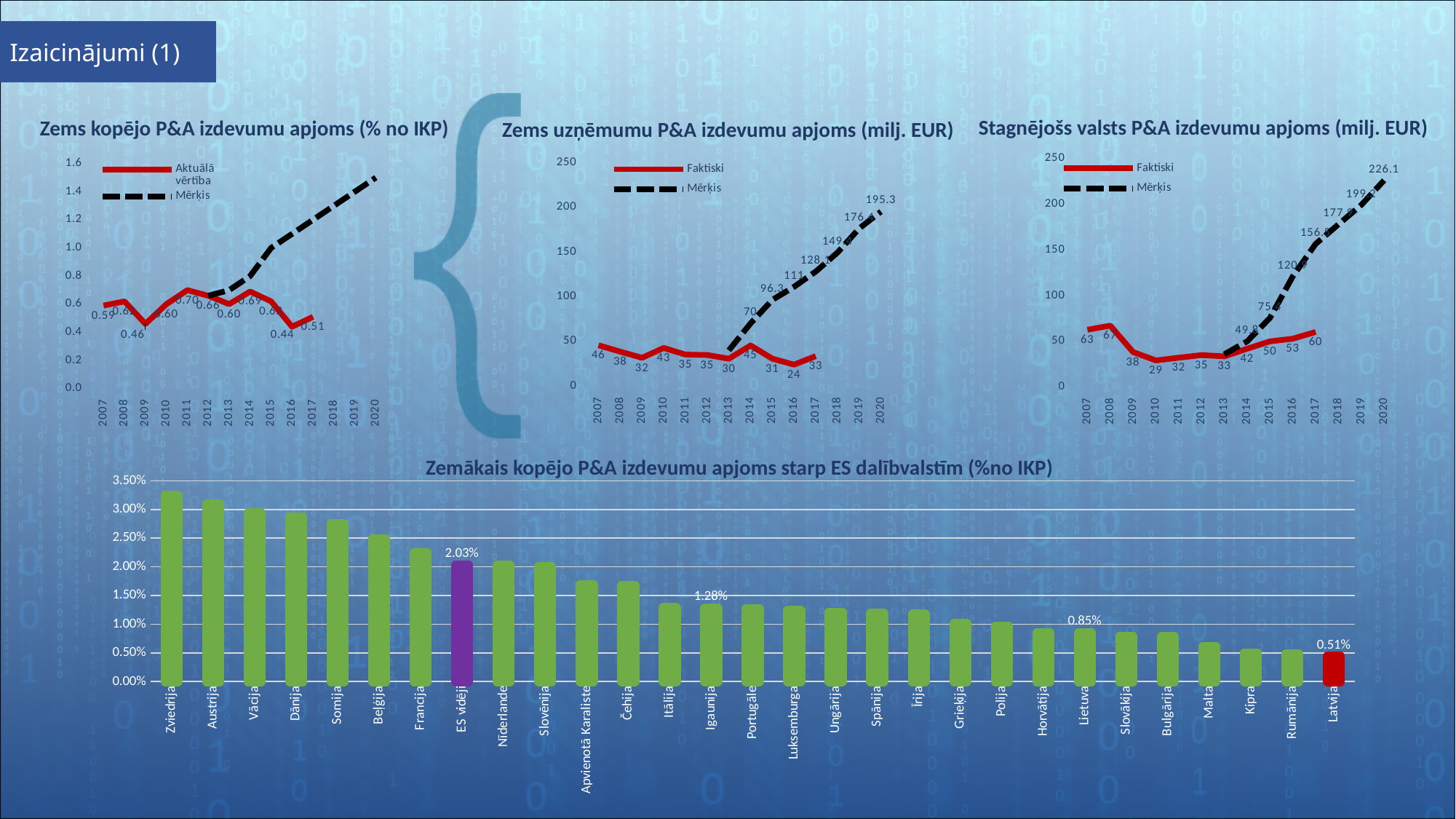
In the chart 'Zems uzņēmumu P&A izdevumu apjoms (milj. EUR)', what is the Faktiski value for 2016? 24 In the chart 'Zems kopējo P&A izdevumu apjoms (% no IKP)', what is the Aktuālā vērtība for 2017? 0.51 In the chart 'Zems kopējo P&A izdevumu apjoms (% no IKP)', which year has the highest Aktuālā vērtība? 2011 In the chart 'Stagnējošs valsts P&A izdevumu apjoms (milj. EUR)', what is the Faktiski value for 2010? 29 In the bottom bar chart, what is the value for Latvija? 0.51% In the chart 'Stagnējošs valsts P&A izdevumu apjoms (milj. EUR)', which is larger, the Faktiski value for 2008 or for 2017? 2008 In the bottom bar chart, is the value for Vācija greater or less than 2.50%? greater In the chart 'Zems uzņēmumu P&A izdevumu apjoms (milj. EUR)', what is the Mērķis value for 2020? 195.3 In the bottom bar chart, which country has the highest value? Zviedrija In the chart 'Zems kopējo P&A izdevumu apjoms (% no IKP)', what is the Aktuālā vērtība for 2009? 0.46 In the chart 'Zems uzņēmumu P&A izdevumu apjoms (milj. EUR)', what is the difference between the Faktiski values for 2007 and 2017? 13 In the chart 'Stagnējošs valsts P&A izdevumu apjoms (milj. EUR)', what is the Mērķis value for 2020? 226.1